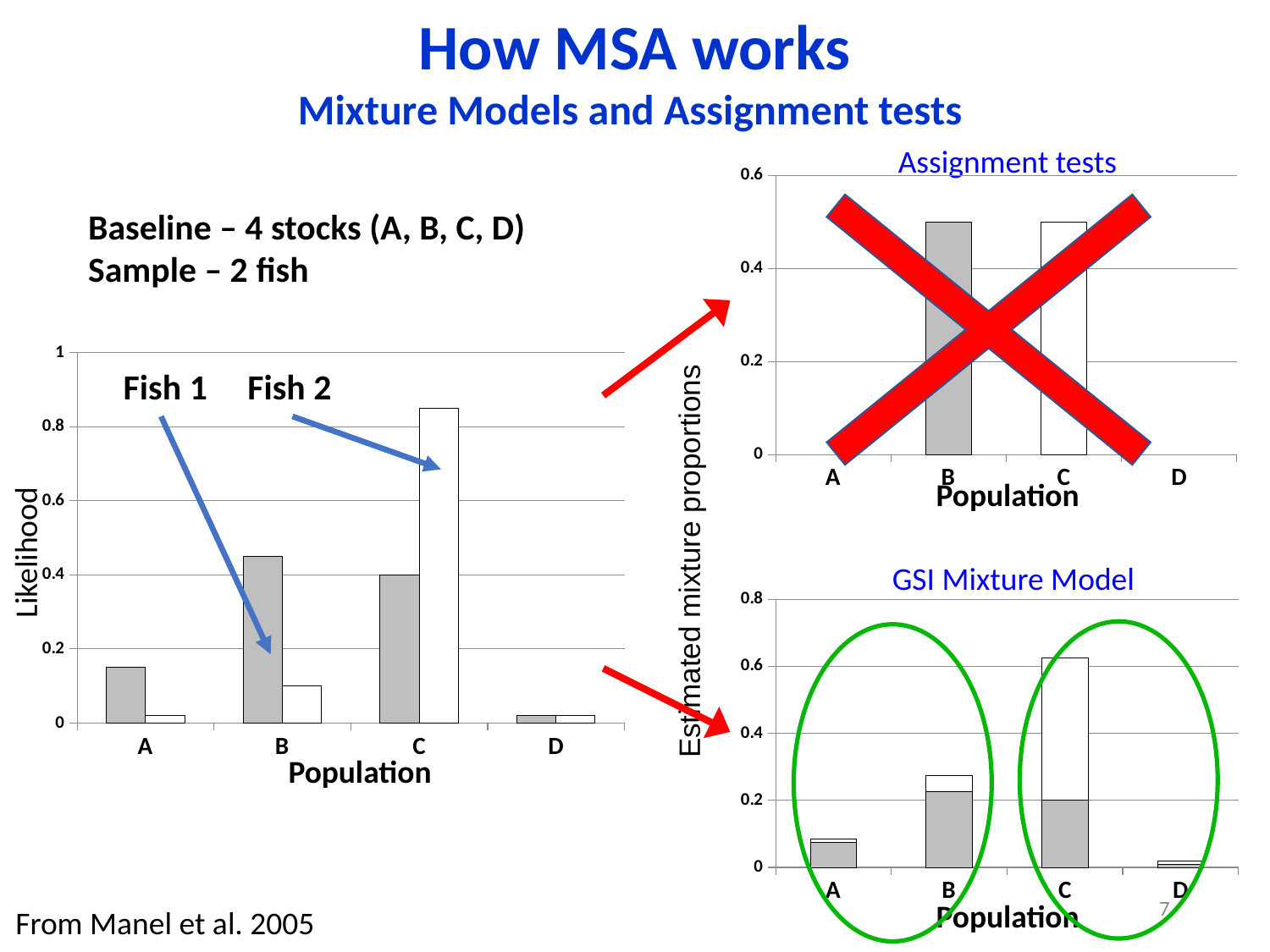
What kind of chart is the left chart with the y-axis labelled Likelihood? bar chart In the Assignment tests chart, is the value for population B greater or less than 0.4? greater In the left Likelihood chart, which population has the highest likelihood for Fish 2? C In the left Likelihood chart, which population has the highest likelihood for Fish 1? B In the left Likelihood chart, for population C, which is larger: the Fish 1 bar or the Fish 2 bar? Fish 2 In the left Likelihood chart, for population B, which is larger: the Fish 1 bar or the Fish 2 bar? Fish 1 In the Assignment tests chart, which populations have a bar plotted? B and C In the left Likelihood chart, is the Fish 2 likelihood for population C greater or less than 0.8? greater In the GSI Mixture Model chart, which population has the tallest stacked bar? C In the GSI Mixture Model chart, which population has the lowest stacked bar? D How many populations are shown on the x-axis of the left Likelihood chart? 4 In the left Likelihood chart, is the Fish 1 likelihood for population B greater or less than 0.4? greater